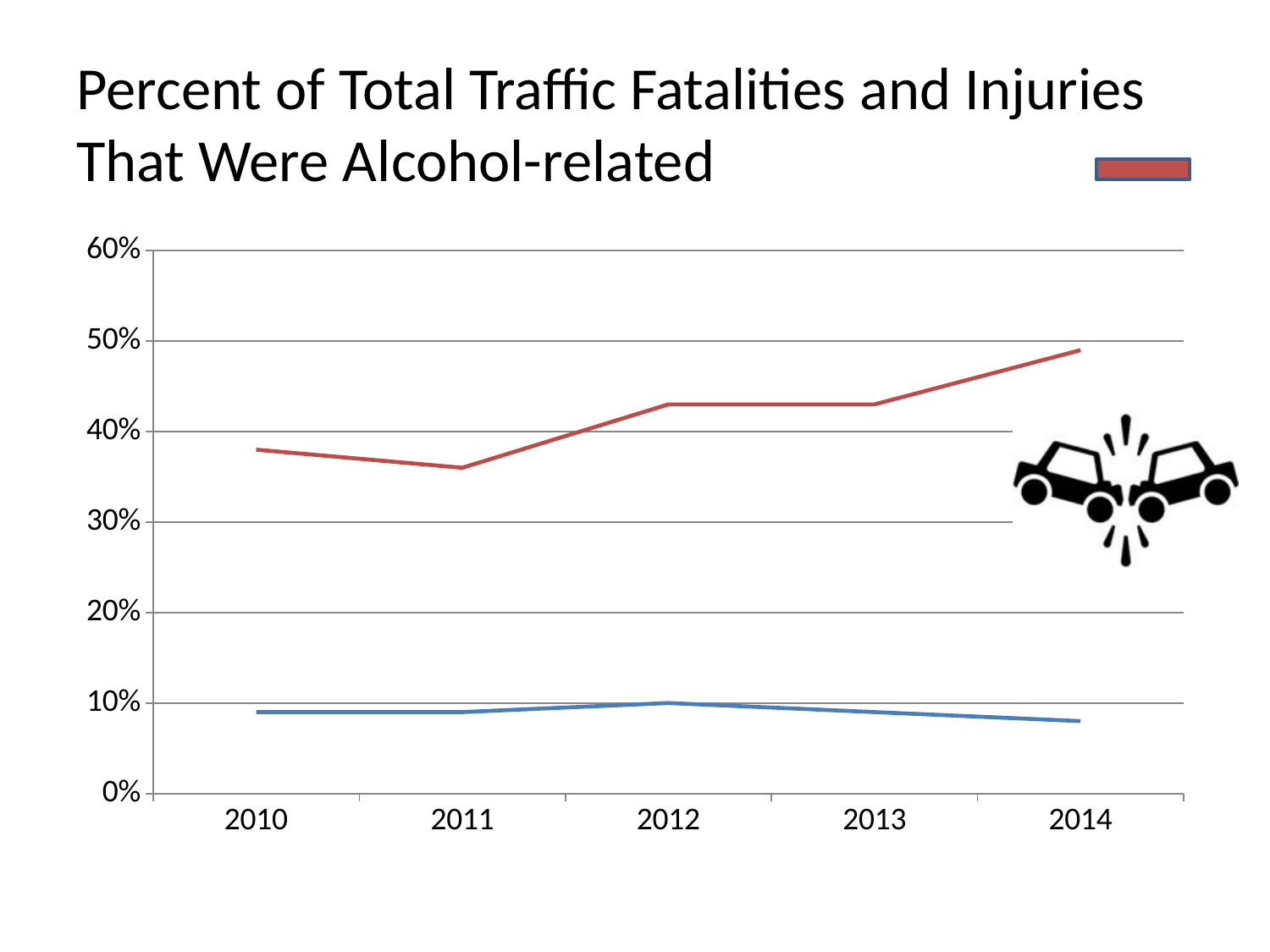
Which year has the highest value for the red line? 2014 Is the value of the blue line in 2010 greater or less than 20%? less Does the red line rise or fall between 2013 and 2014? rise Is the value of the red line in 2012 greater or less than 40%? greater What is the title of the chart? Percent of Total Traffic Fatalities and Injuries That Were Alcohol-related Is the value of the blue line in 2014 greater or less than 10%? less Which line has the higher value in 2013, the red line or the blue line? the red line How many lines are plotted on the chart? 2 How many years are shown on the x axis of the chart? 5 What kind of chart is shown on the slide? line chart